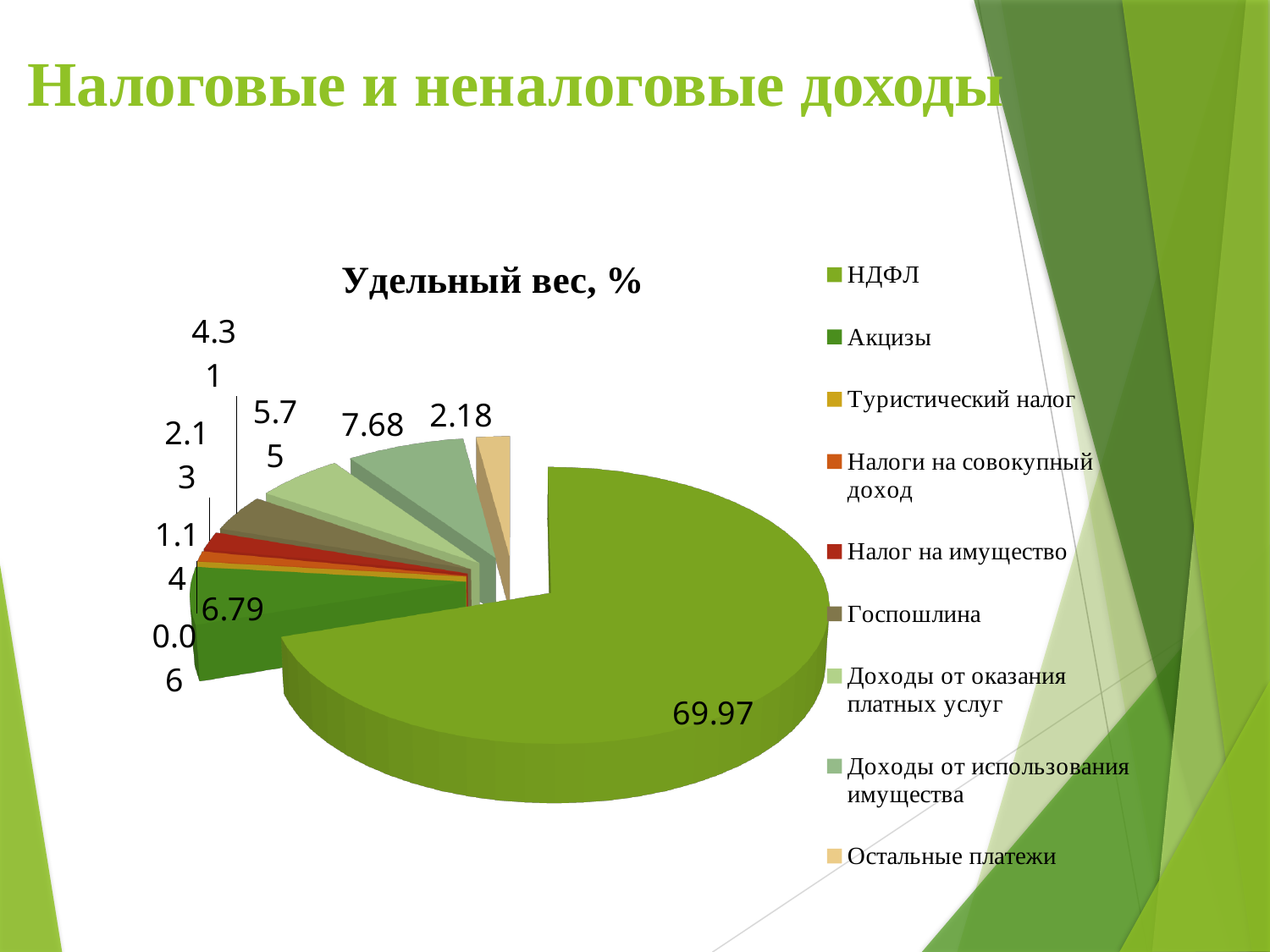
What is the title of the chart? Удельный вес, % What is the value shown for Доходы от использования имущества? 7.68 What is the difference between the value for НДФЛ and the value for Доходы от использования имущества? 62.29 What is the value shown for Акцизы? 6.79 Which category has the largest share of the pie? НДФЛ What is the value shown for Госпошлина? 4.31 Which category has the smallest share of the pie? Туристический налог Which is larger, the value for Акцизы or the value for Доходы от использования имущества? Доходы от использования имущества What type of chart is shown on the slide? Pie chart What is the value shown for НДФЛ? 69.97 How many categories does the legend of the pie chart list? 9 What is the value shown for Остальные платежи? 2.18